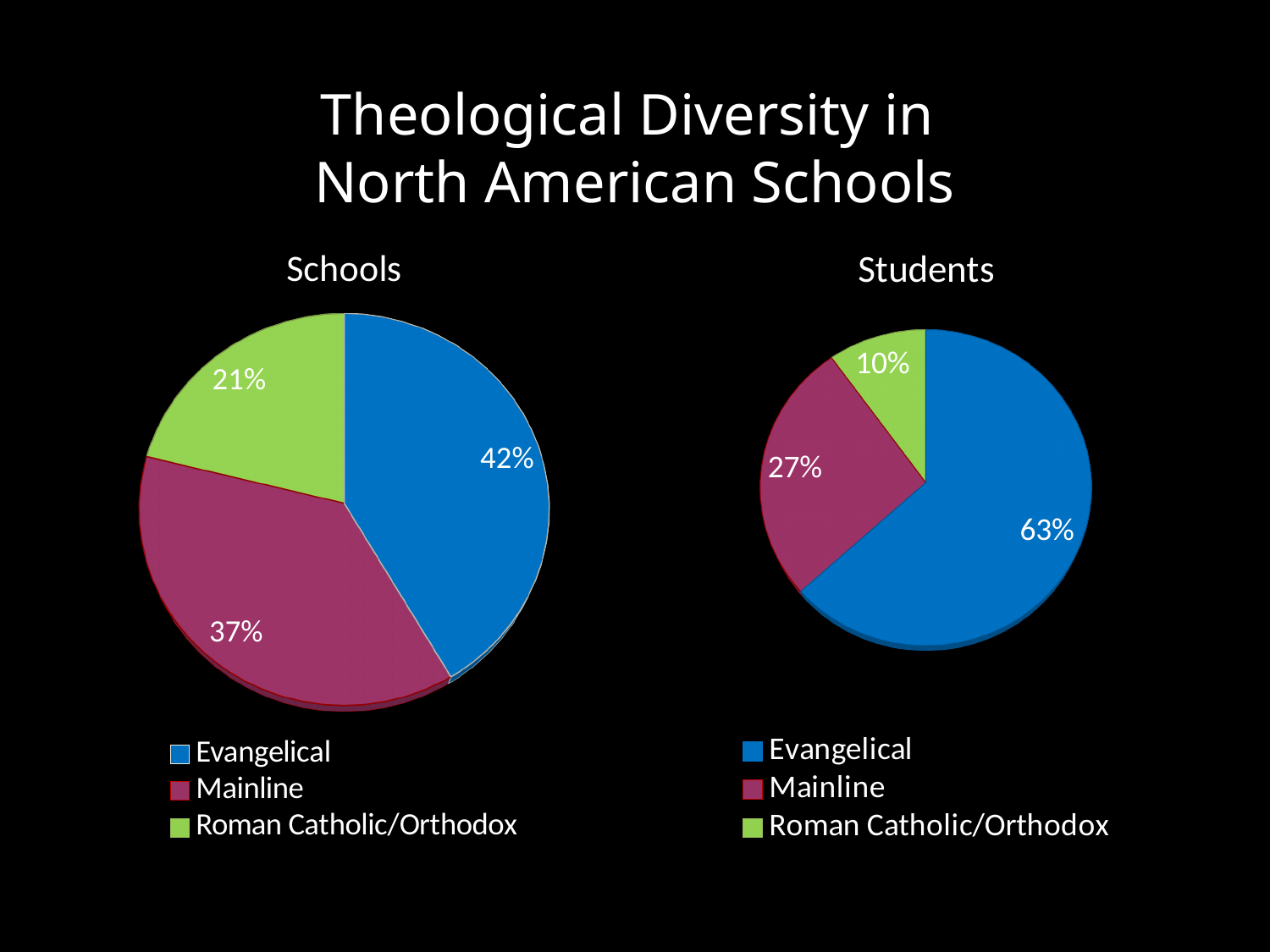
How many categories does the legend of the Students chart list? 3 In the Schools pie chart, which category has the smallest share? Roman Catholic/Orthodox In the Schools pie chart, what percentage is Evangelical? 42% In the Schools pie chart, what percentage is Roman Catholic/Orthodox? 21% In the Students pie chart, what percentage is Mainline? 27% What type of chart is used for the Schools chart? Pie chart In the Students pie chart, what percentage is Evangelical? 63% In the Students pie chart, what percentage is Roman Catholic/Orthodox? 10% In the Students pie chart, which category has the largest share? Evangelical Which is larger: the Evangelical share in the Students chart or the Evangelical share in the Schools chart? Students In the Schools pie chart, what percentage is Mainline? 37% In the Schools pie chart, what is the difference between the Evangelical and Mainline shares? 5%